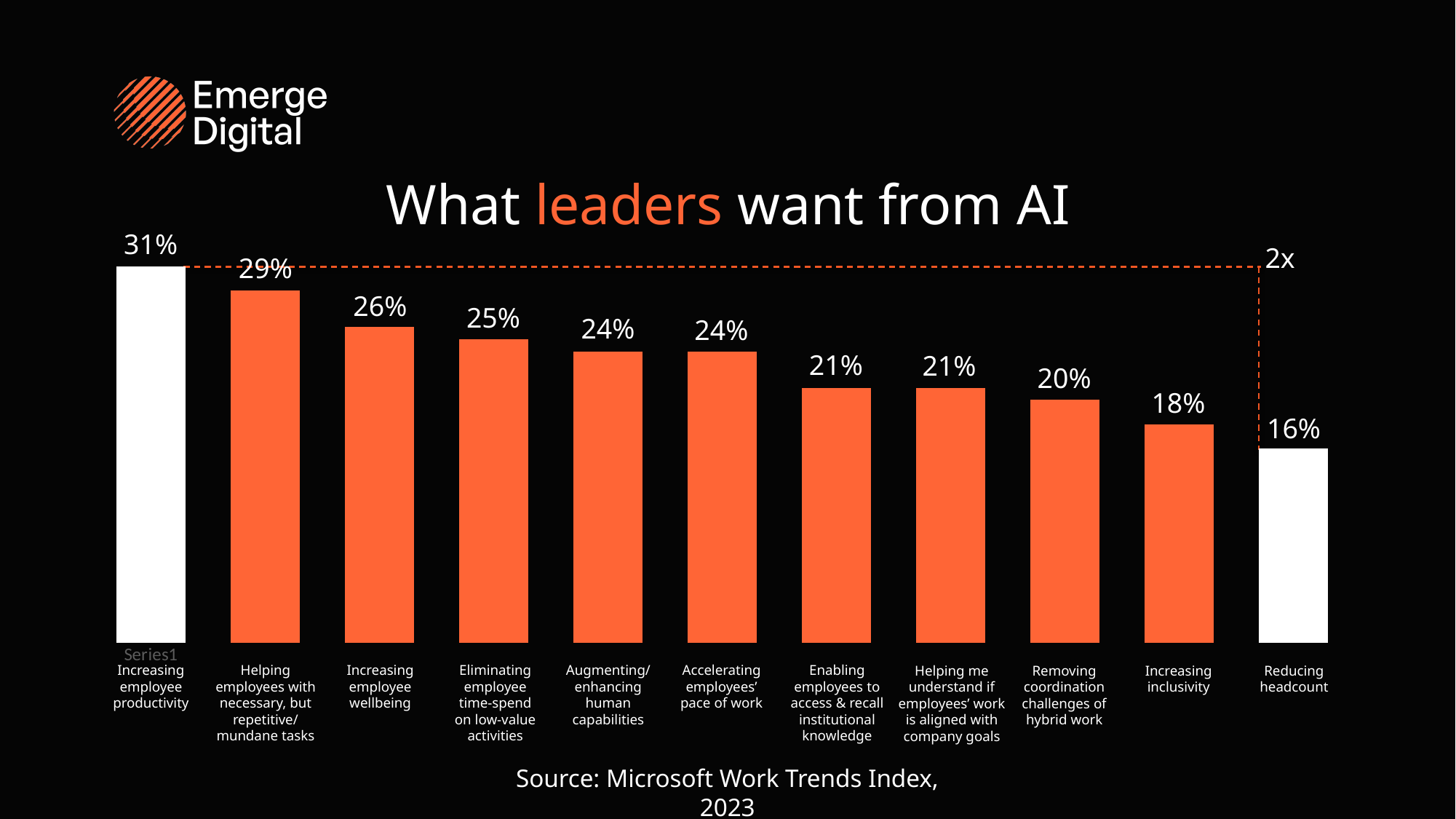
Which category has the highest value? Increasing employee productivity What is the difference between Increasing employee productivity and Reducing headcount? 15% How many categories are shown in the chart? 11 Which is larger: Helping employees with necessary, but repetitive/mundane tasks or Removing coordination challenges of hybrid work? Helping employees with necessary, but repetitive/mundane tasks What is the value for Increasing employee productivity? 31% What is the value for Reducing headcount? 16% What is the value for Increasing inclusivity? 18% What is the value for Increasing employee wellbeing? 26% What kind of chart is shown on the slide? Bar chart Do the values rise or fall from left to right across the chart? Fall Which category has the lowest value? Reducing headcount What is the title of the chart? What leaders want from AI